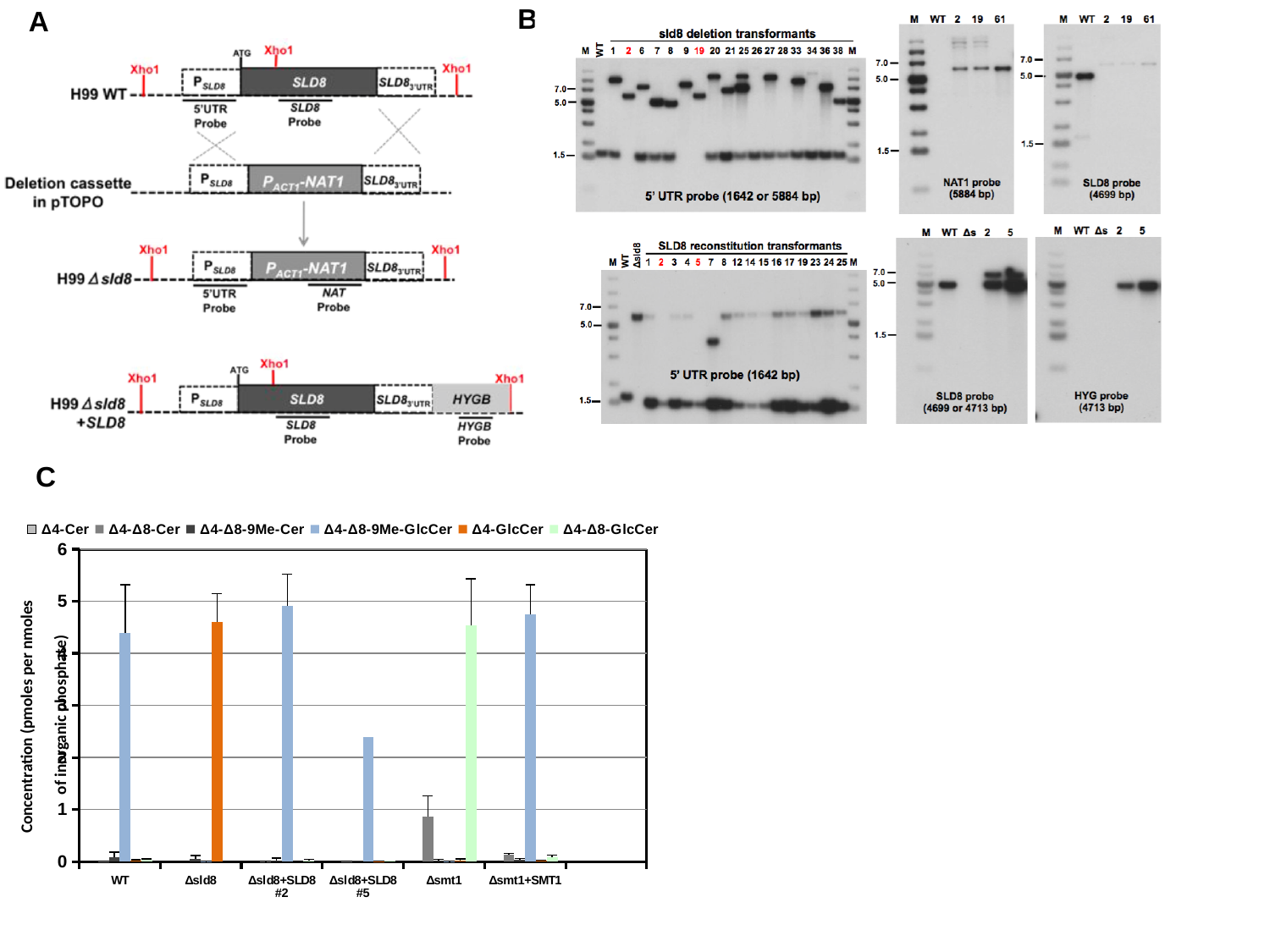
In the panel C chart, is the Δ4-Δ8-GlcCer value for Δsmt1 greater or less than 4? greater In the panel C chart, is the Δ4-Δ8-Cer value for Δsmt1 greater or less than 1? less In the panel C chart, which has the larger Δ4-Δ8-9Me-GlcCer value, WT or Δsld8+SLD8 #5? WT In the panel C chart, which has the larger Δ4-Δ8-9Me-GlcCer value, Δsld8+SLD8 #2 or Δsld8+SLD8 #5? Δsld8+SLD8 #2 In the panel C chart, which series is shown in orange? Δ4-GlcCer In the panel C chart, how many series does the legend list? 6 In the panel C chart, is the Δ4-Δ8-9Me-GlcCer value for WT greater or less than 4? greater In the panel C chart, how many categories are shown on the x axis? 6 In the panel C chart, which category has the orange Δ4-GlcCer bar as its tallest bar? Δsld8 What kind of chart is shown in panel C? bar chart